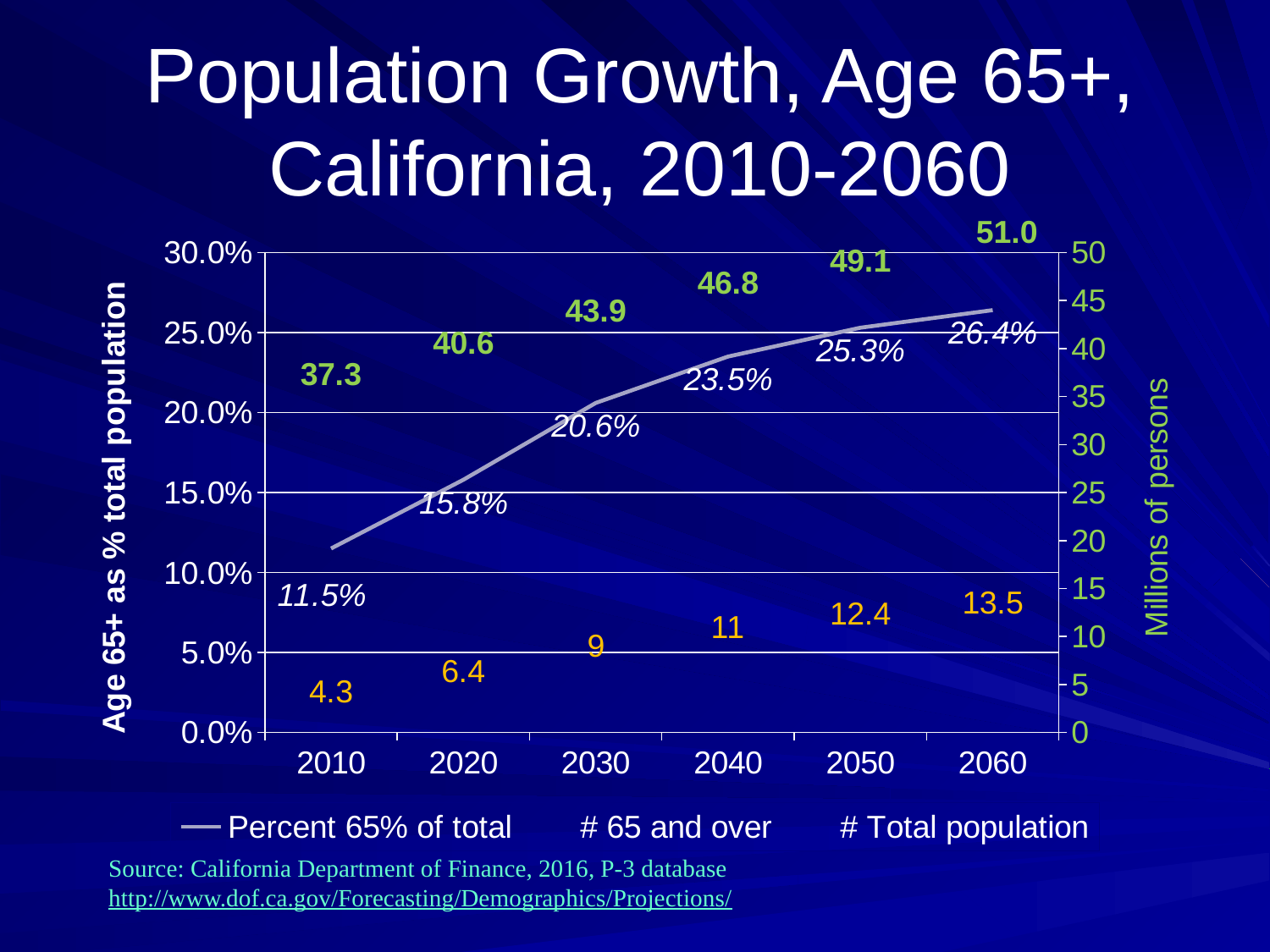
In which year does the 'Percent 65% of total' series reach its highest value? 2060 What is the '# 65 and over' value shown for 2050? 12.4 Which is larger, the '# 65 and over' value in 2040 or in 2020? 2040 What is the '# Total population' value shown for 2020? 40.6 How many years are shown on the x axis? 6 What is the value of the 'Percent 65% of total' series in 2030? 20.6% What is the label of the right-hand vertical axis? Millions of persons What is the difference between the '# Total population' values for 2060 and 2010? 13.7 By how many percentage points does 'Percent 65% of total' increase from 2010 to 2060? 14.9 How many series does the legend list? 3 In which year is the '# 65 and over' value lowest? 2010 Does the 'Percent 65% of total' series rise or fall from 2010 to 2060? rise